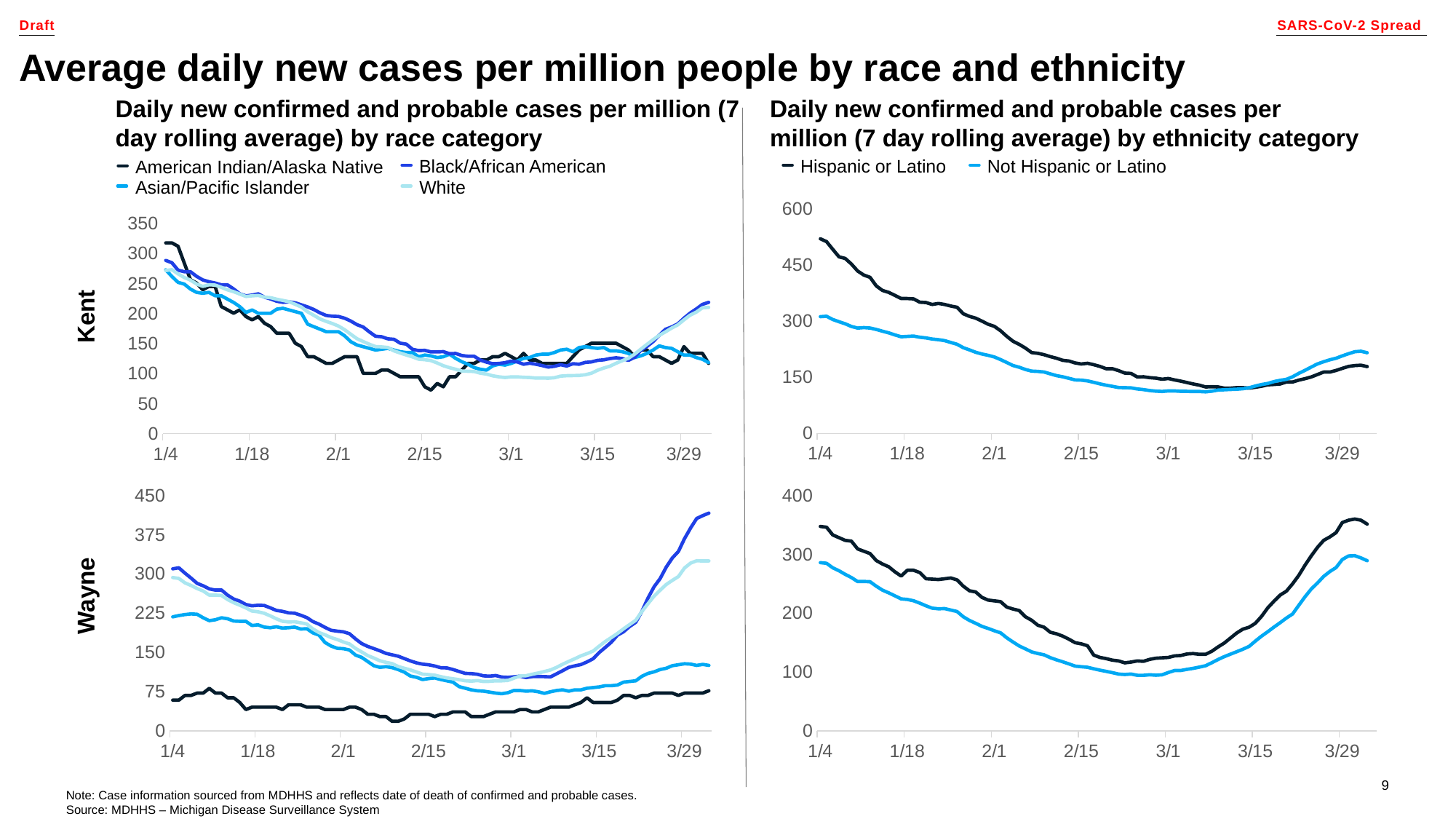
What is the first date shown on the x axis of the Kent chart by race category? 1/4 In the Wayne chart by ethnicity category, is the value for Not Hispanic or Latino on 2/15 greater or less than 150? less What type of chart is the Kent chart by race category? Line chart In the Wayne chart by ethnicity category, which series has the higher value on 1/4, Hispanic or Latino or Not Hispanic or Latino? Hispanic or Latino In the Kent chart by race category, which series has the highest value on 1/4? American Indian/Alaska Native In the Kent chart by ethnicity category, is the value for Hispanic or Latino on 1/4 greater or less than 450? greater How many series does the legend list for the charts by race category? 4 In the Wayne chart by race category, is the value for Black/African American at the end of the series (after 3/29) greater or less than 375? greater How many series does the legend list for the charts by ethnicity category? 2 In the Wayne chart by race category, which series has the lowest values across the whole period? American Indian/Alaska Native In the Kent chart by ethnicity category, does the Hispanic or Latino line rise or fall from 1/4 to 3/1? Fall In the Wayne chart by race category, does the Black/African American line rise or fall from 3/1 to 3/29? Rise